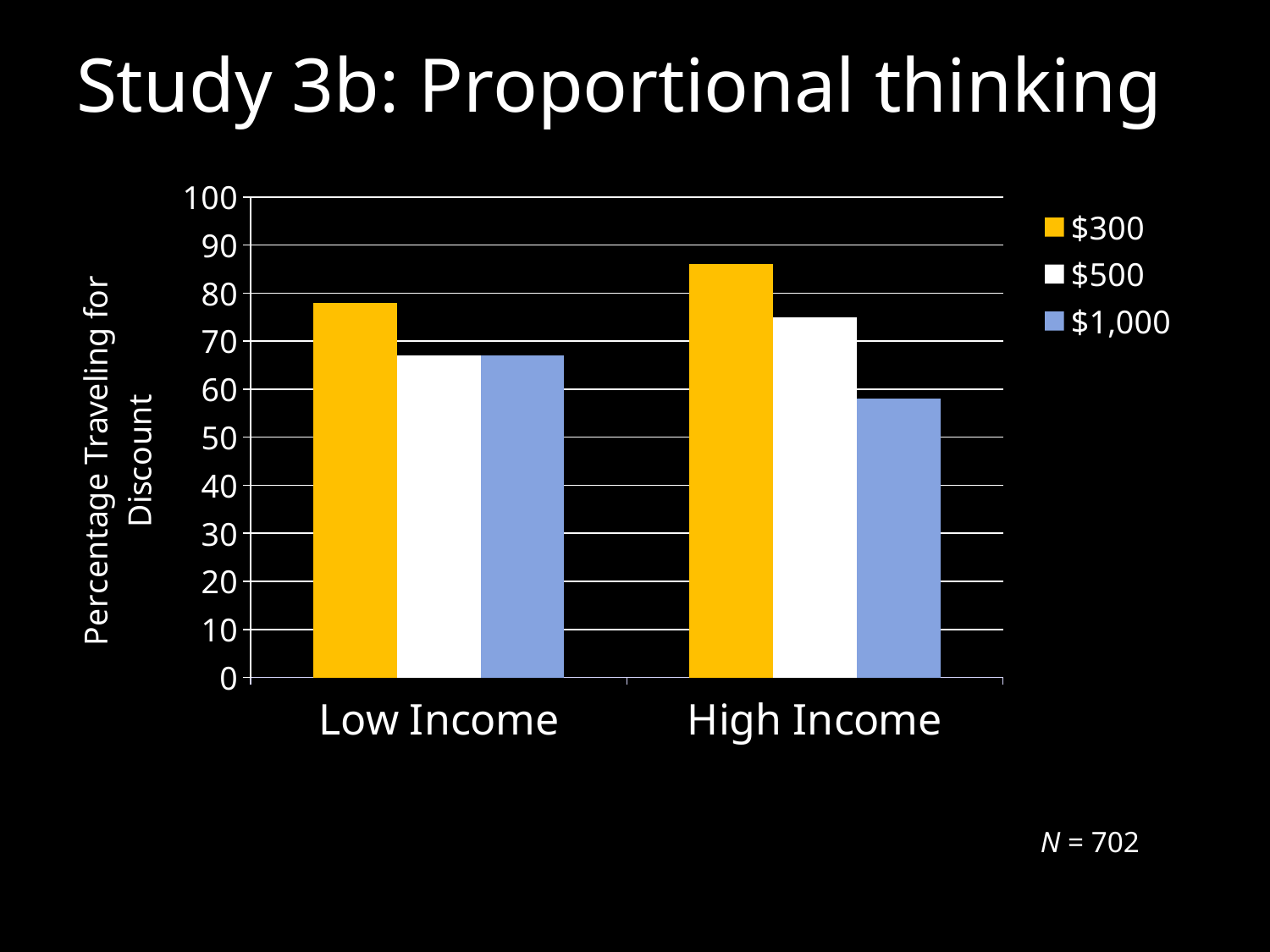
How many series does the legend list? 3 Which is larger: the $300 value for Low Income or the $300 value for High Income? High Income Which series has the highest value in the High Income group? $300 How many income categories are shown on the x axis? 2 Is the value for $1,000 in the High Income group greater or less than 60? less Which series has the lowest value in the High Income group? $1,000 What is the label on the vertical axis? Percentage Traveling for Discount Is the value for $300 in the Low Income group greater or less than 70? greater Which series has the highest value in the Low Income group? $300 Which is larger: the $1,000 value for Low Income or the $1,000 value for High Income? Low Income What kind of chart is shown on the slide? bar chart Is the value for $300 in the High Income group greater or less than 80? greater